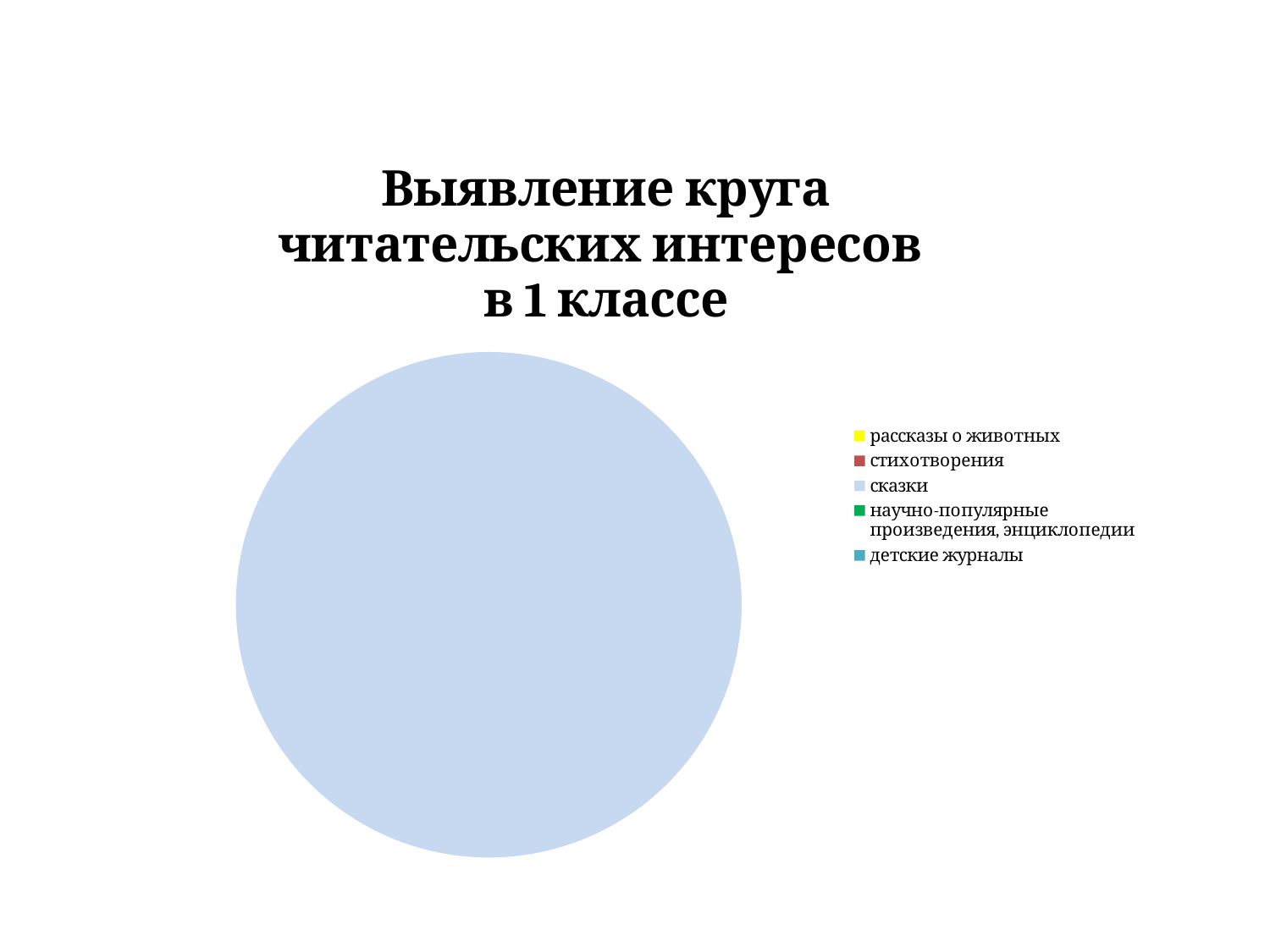
Which of the two categories, сказки or детские журналы, has the larger share of the pie? сказки How many categories does the legend of the pie chart list? 5 What is the title of the chart on the slide? Выявление круга читательских интересов в 1 классе Which category has the largest share of the pie chart? сказки Which legend entry is shown in light blue? сказки What kind of chart is shown on the slide? pie chart Which of the two categories, сказки or стихотворения, has the larger share of the pie? сказки